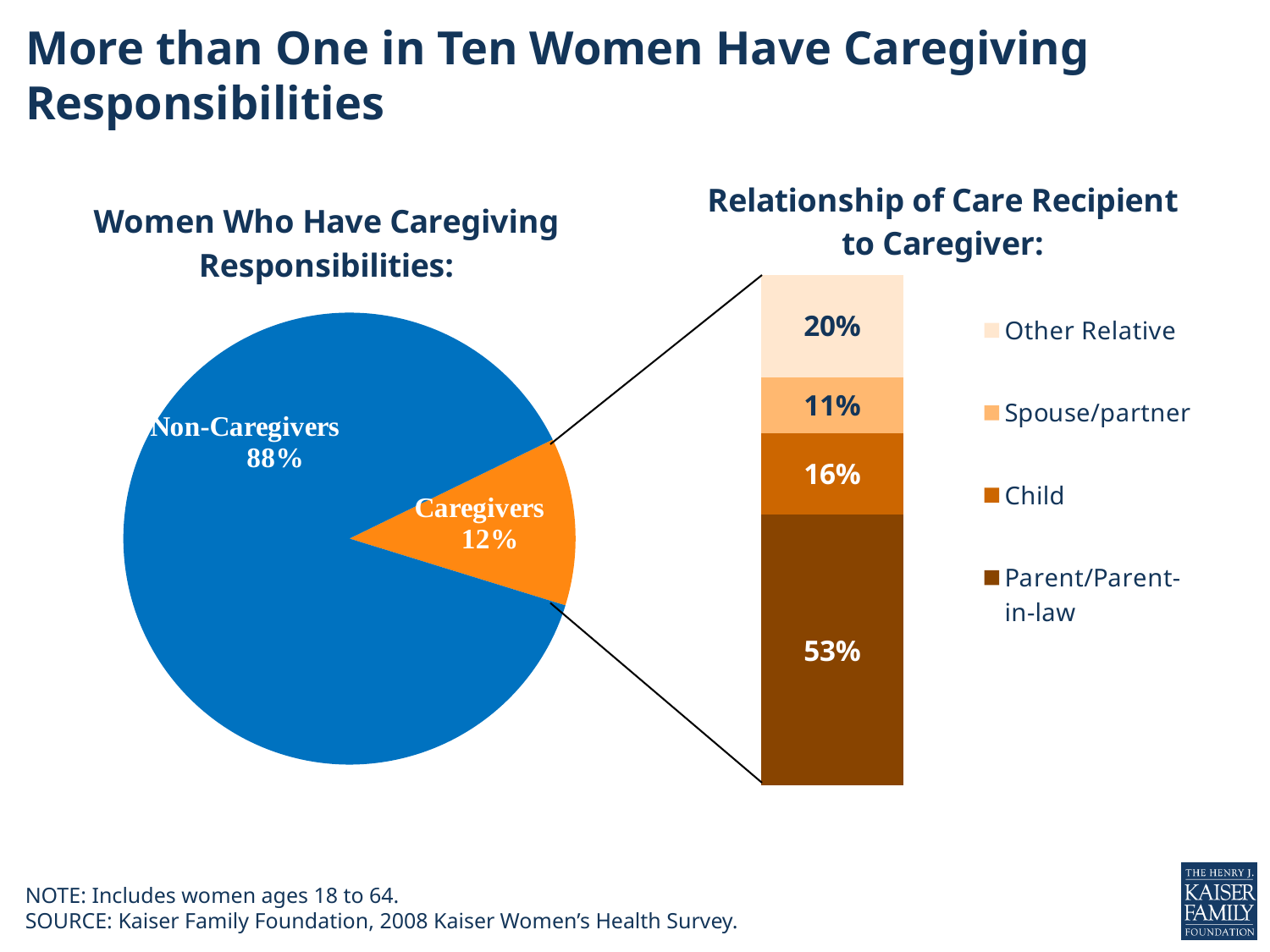
How many slices does the 'Women Who Have Caregiving Responsibilities' pie chart have? 2 In the 'Relationship of Care Recipient to Caregiver' chart, which is larger: Other Relative or Child? Other Relative In the 'Women Who Have Caregiving Responsibilities' pie chart, what share of women are Caregivers? 12% In the 'Relationship of Care Recipient to Caregiver' chart, what is the value for Child? 16% In the 'Relationship of Care Recipient to Caregiver' chart, which relationship has the largest share? Parent/Parent-in-law In the 'Relationship of Care Recipient to Caregiver' chart, what is the difference between the Parent/Parent-in-law and Other Relative values? 33 percentage points In the 'Relationship of Care Recipient to Caregiver' chart, which relationship has the smallest share? Spouse/partner In the 'Relationship of Care Recipient to Caregiver' chart, what is the value for Spouse/partner? 11% In the 'Relationship of Care Recipient to Caregiver' chart, what is the value for Parent/Parent-in-law? 53% In the 'Women Who Have Caregiving Responsibilities' pie chart, what share of women are Non-Caregivers? 88% What kind of chart is 'Women Who Have Caregiving Responsibilities'? pie chart How many entries does the legend of the 'Relationship of Care Recipient to Caregiver' chart list? 4